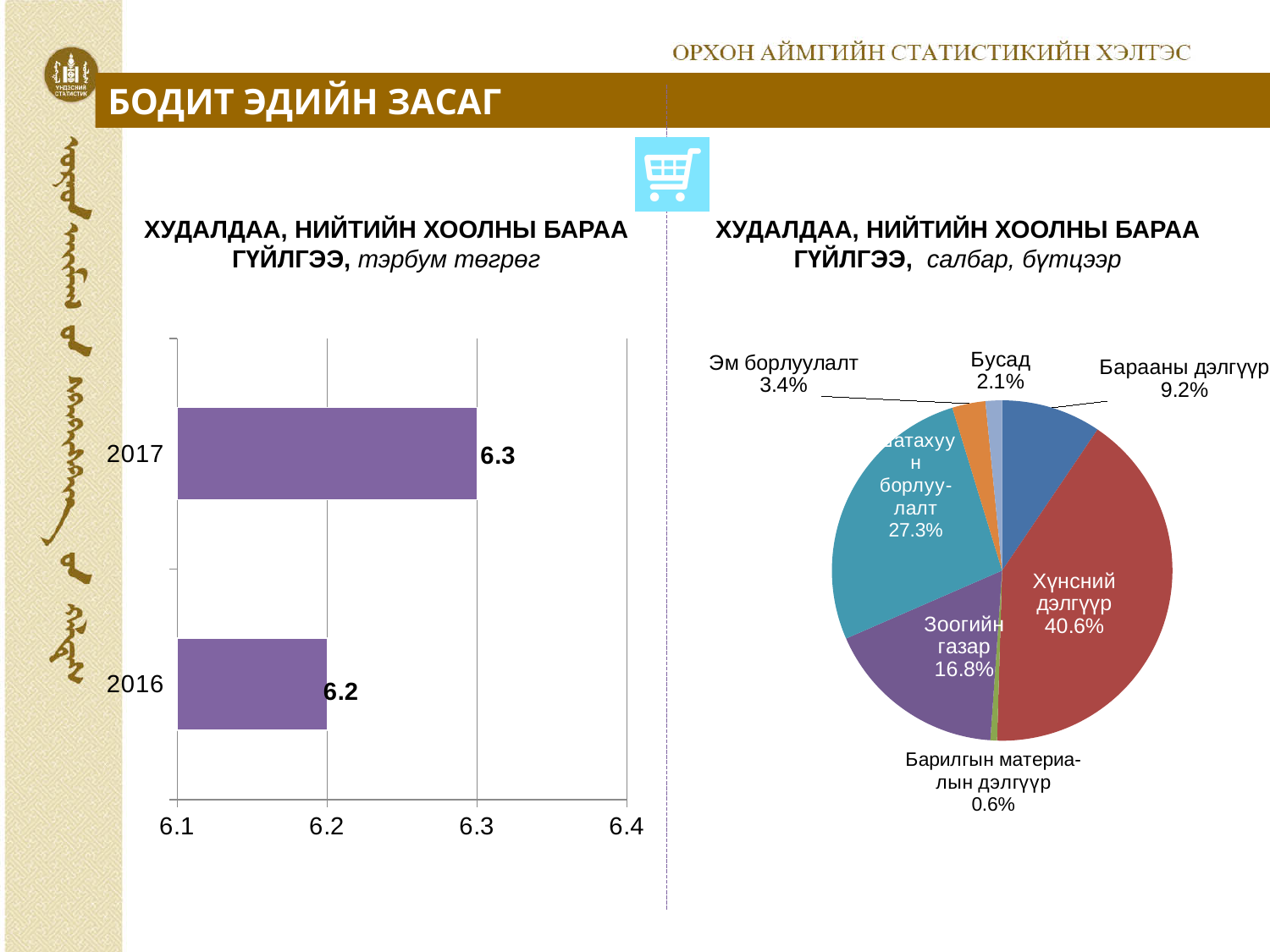
In the right pie chart, what share does 'Хүнсний дэлгүүр' have? 40.6% In the left bar chart, what is the value for 2016? 6.2 What type of chart is the left chart titled 'ХУДАЛДАА, НИЙТИЙН ХООЛНЫ БАРАА ГҮЙЛГЭЭ, тэрбум төгрөг'? bar chart In the left bar chart, what is the difference between the 2017 and 2016 values? 0.1 In the right pie chart, what share does 'Зоогийн газар' have? 16.8% What type of chart is the right chart titled 'ХУДАЛДАА, НИЙТИЙН ХООЛНЫ БАРАА ГҮЙЛГЭЭ, салбар, бүтцээр'? pie chart In the left bar chart, which year has the higher value, 2016 or 2017? 2017 In the right pie chart, which category has the largest share? Хүнсний дэлгүүр In the right pie chart, which category has the smallest share? Барилгын материалын дэлгүүр In the right pie chart, which is larger, 'Барааны дэлгүүр' or 'Эм борлуулалт'? Барааны дэлгүүр In the left bar chart, how many years are shown? 2 In the left bar chart, what is the value for 2017? 6.3